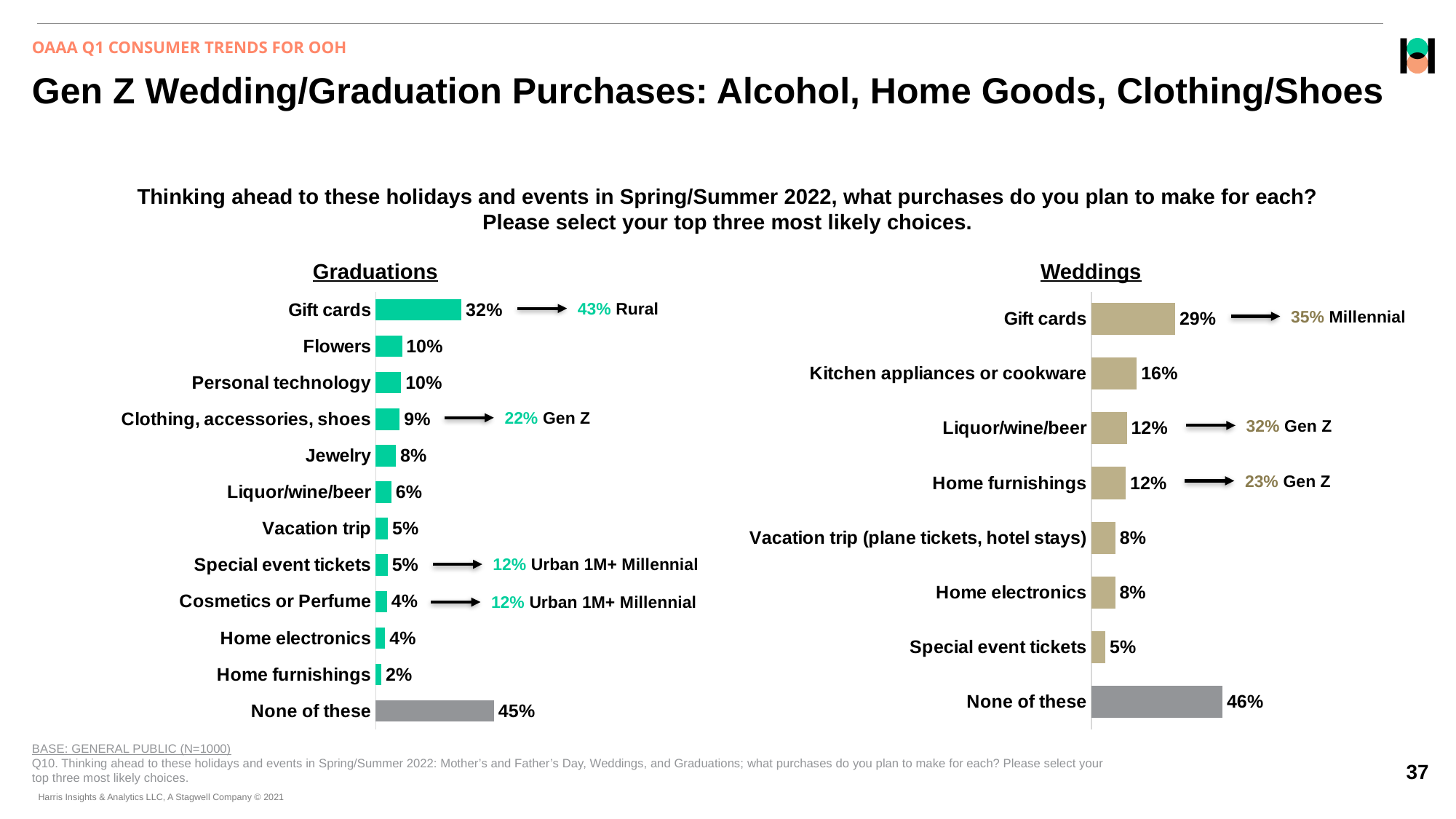
In the Graduations chart, what percentage of Gen Z is shown for Clothing, accessories, shoes? 22% In the Graduations chart, what percentage is shown for Gift cards? 32% Which is larger: Liquor/wine/beer in the Graduations chart or Liquor/wine/beer in the Weddings chart? Weddings In the Weddings chart, what is the difference between Gift cards and Liquor/wine/beer? 17% In the Weddings chart, which category has the highest value? None of these In the Weddings chart, what percentage of Millennials is shown for Gift cards? 35% How many categories are shown in the Weddings chart? 8 How many categories are shown in the Graduations chart? 12 What type of chart is the Weddings chart? Bar chart In the Graduations chart, which category has the lowest value? Home furnishings In the Graduations chart, what is the difference between None of these and Gift cards? 13% In the Weddings chart, what percentage is shown for Kitchen appliances or cookware? 16%